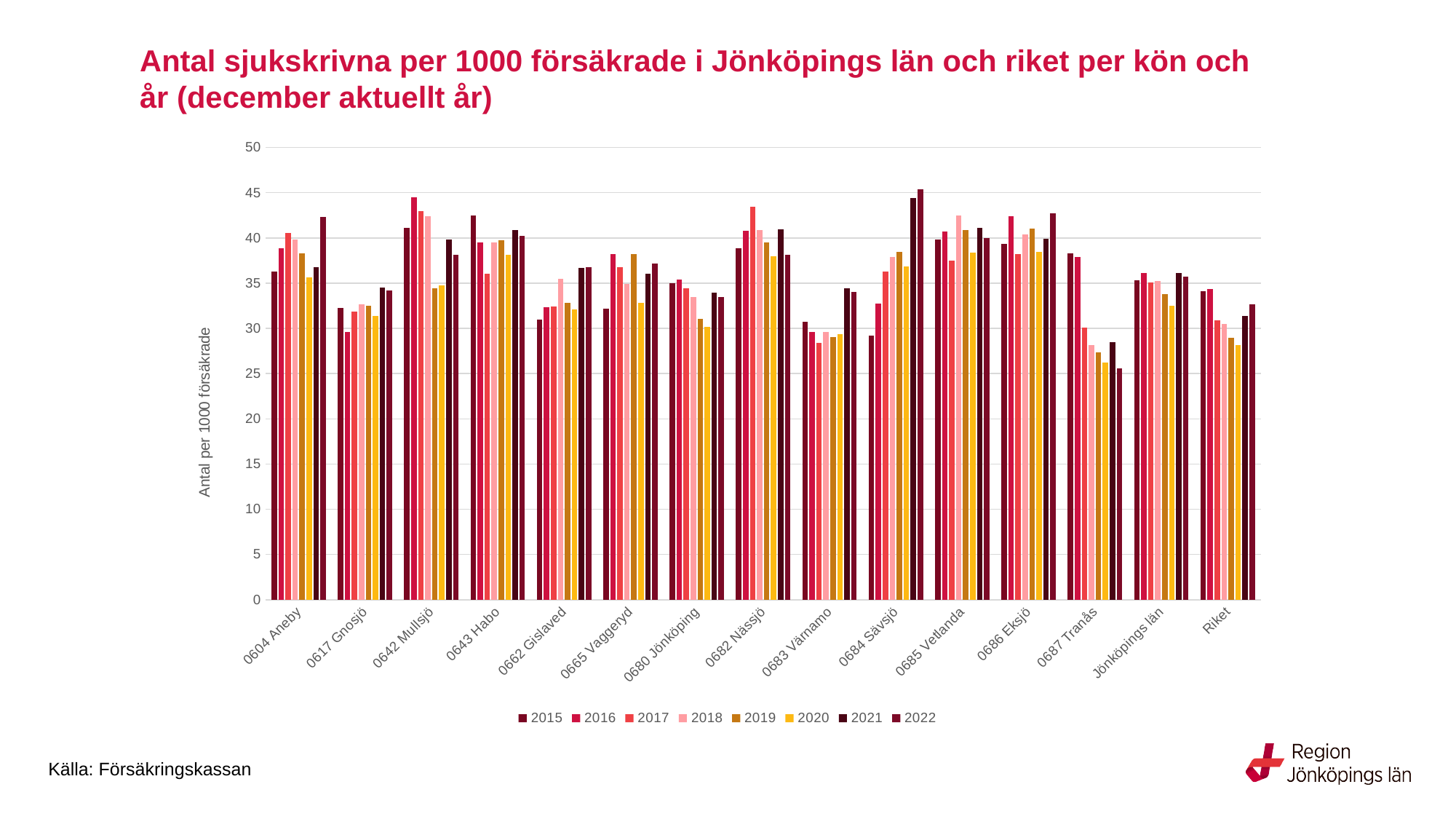
Is the value for 2022 in 0684 Sävsjö greater or less than 40? greater What is the label on the y axis? Antal per 1000 försäkrade Is the value for 2016 in 0642 Mullsjö greater or less than 40? greater Is the value for 2020 in 0687 Tranås greater or less than 30? less Which is larger for 0687 Tranås, the 2015 value or the 2022 value? 2015 What kind of chart is shown on the slide? Bar chart How many series does the legend list? 8 Which year has the highest value for 0642 Mullsjö? 2016 How many categories are shown along the x axis? 15 Which is larger, the 2016 value for 0604 Aneby or the 2016 value for 0617 Gnosjö? 0604 Aneby